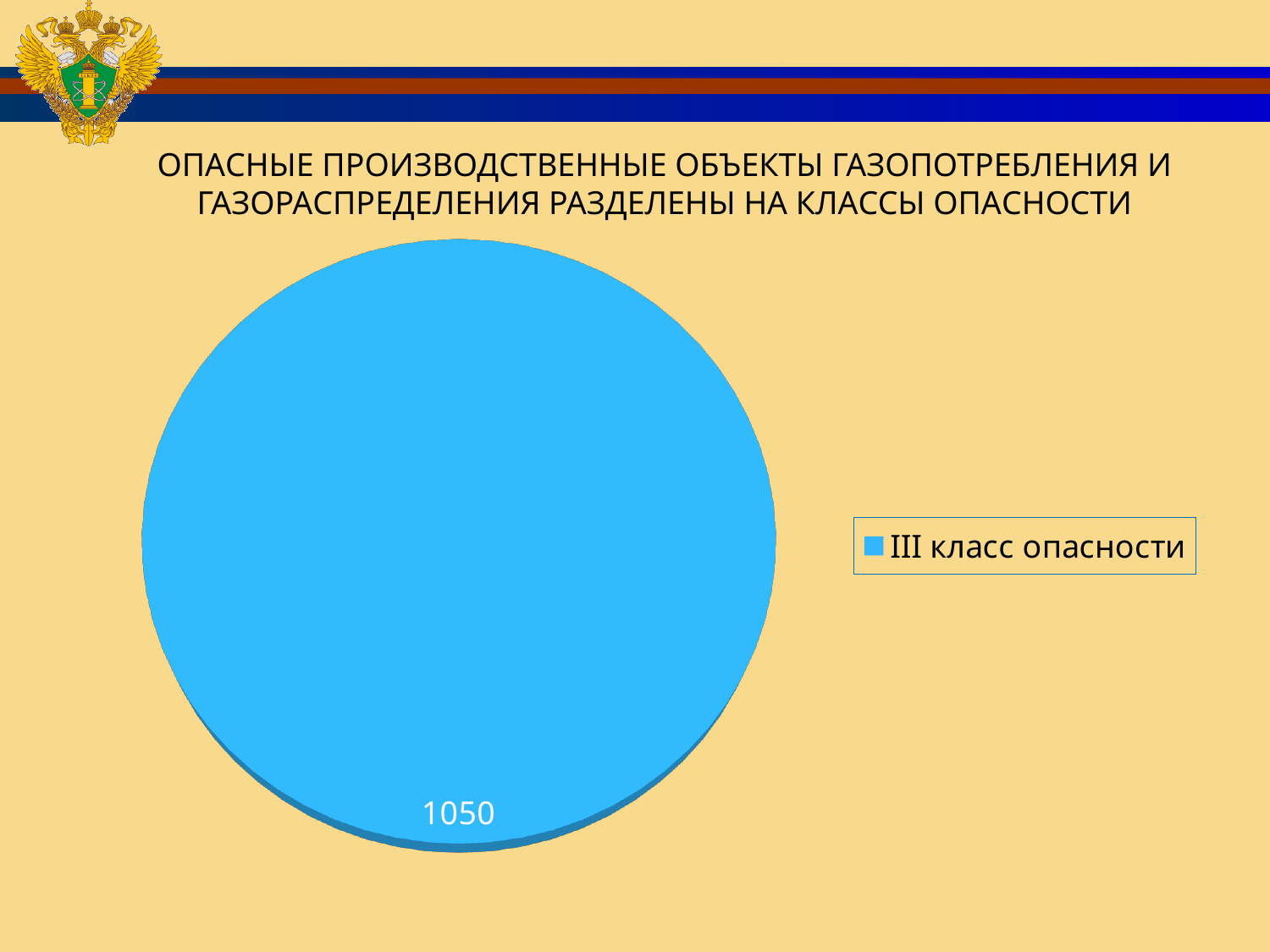
What is the label of the only legend entry in the pie chart? III класс опасности What colour is the III класс опасности slice in the pie chart? blue What share of the pie does the III класс опасности slice represent? 100% What kind of chart is shown on the slide? pie chart How many entries does the legend of the pie chart list? 1 How many slices does the pie chart contain? 1 What is the total of all values shown in the pie chart? 1050 What value is shown for the III класс опасности slice in the pie chart? 1050